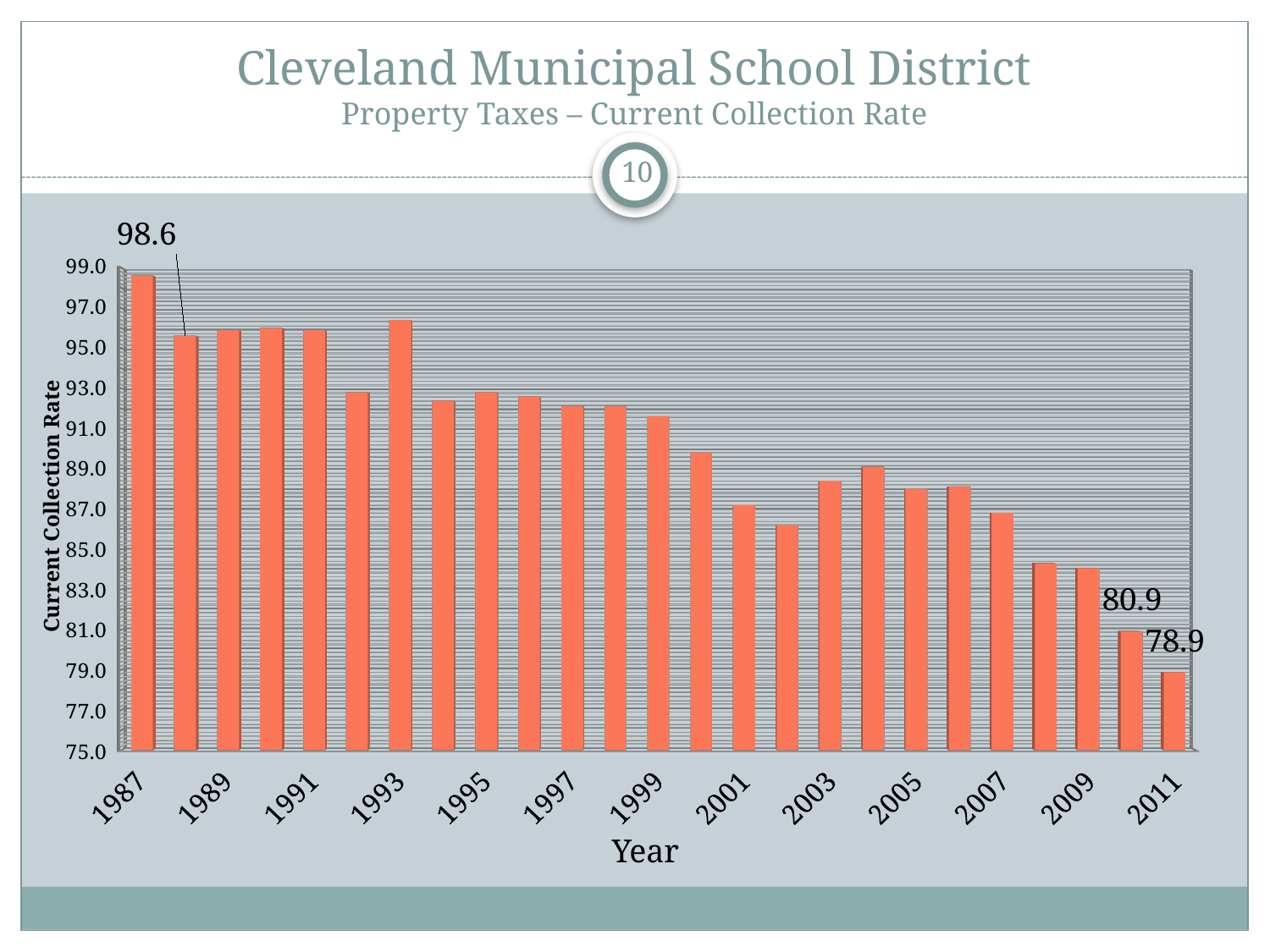
What is the difference between the highest value (98.6) and the 2011 value (78.9)? 19.7 What is the difference between the collection rates for 2010 and 2011? 2.0 Is the value for 1993 greater or less than 95.0? greater Which year has the highest current collection rate? 1987 What is the current collection rate for 2011? 78.9 Which year has the lowest current collection rate? 2011 Overall, do the collection rates rise or fall from 1987 to 2011? fall What is the current collection rate for 2010? 80.9 What is the title of the vertical axis? Current Collection Rate What is the highest current collection rate shown on the chart? 98.6 What kind of chart is shown on the slide? bar chart Which year has the larger collection rate, 1992 or 1993? 1993